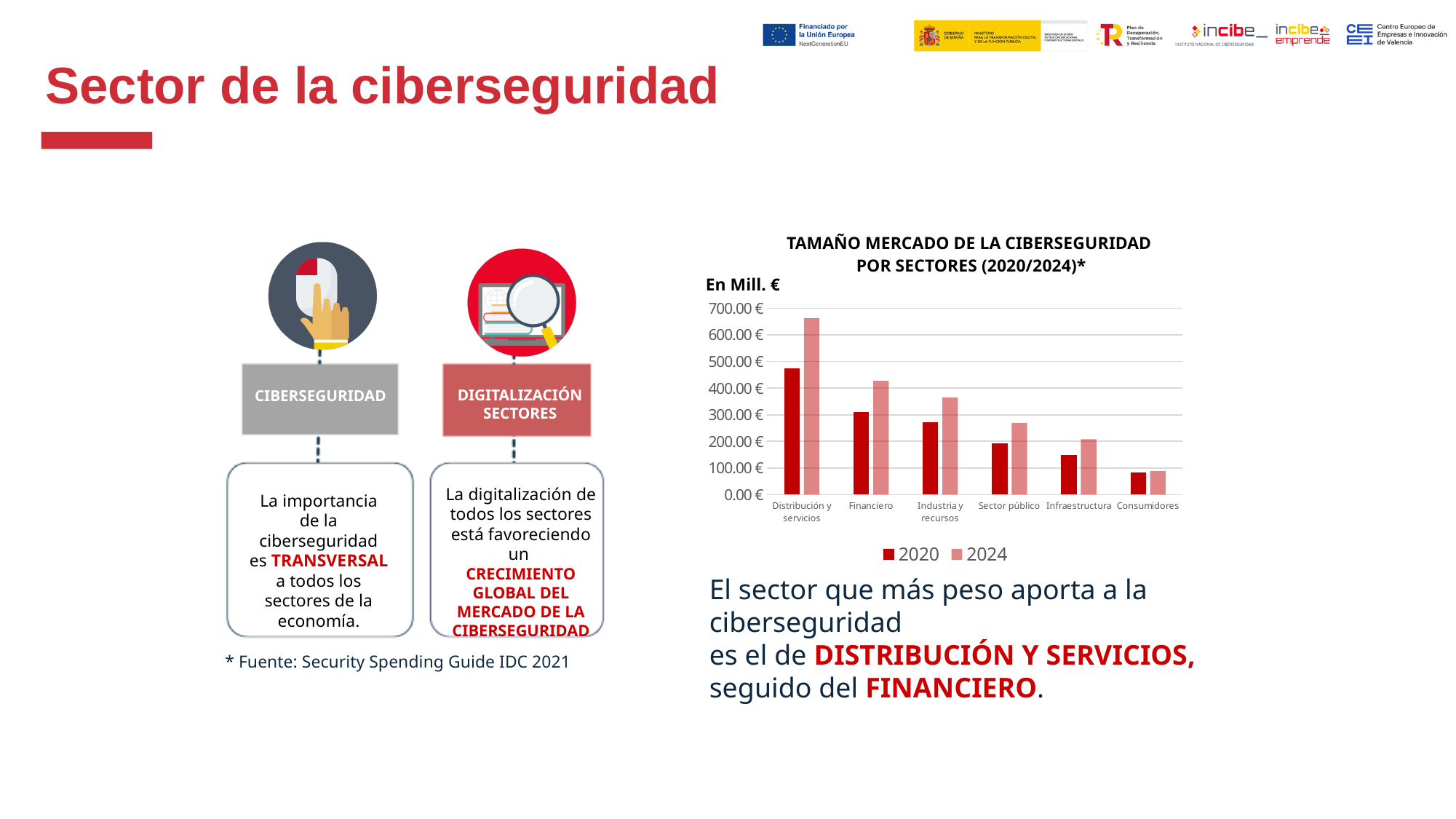
Which sector has the lowest value for 2020? Consumidores What unit is indicated above the y axis of the chart? En Mill. € What type of chart is shown on the slide? bar chart Which is larger for Financiero: the 2020 value or the 2024 value? 2024 How many sectors (categories) are shown on the x axis of the chart? 6 Is the 2024 value for Distribución y servicios greater or less than 600.00 €? greater Is the 2024 value for Financiero greater or less than 400.00 €? greater Is the 2020 value for Consumidores greater or less than 100.00 €? less How many series does the chart legend list? 2 Which sector has the highest value for 2024? Distribución y servicios